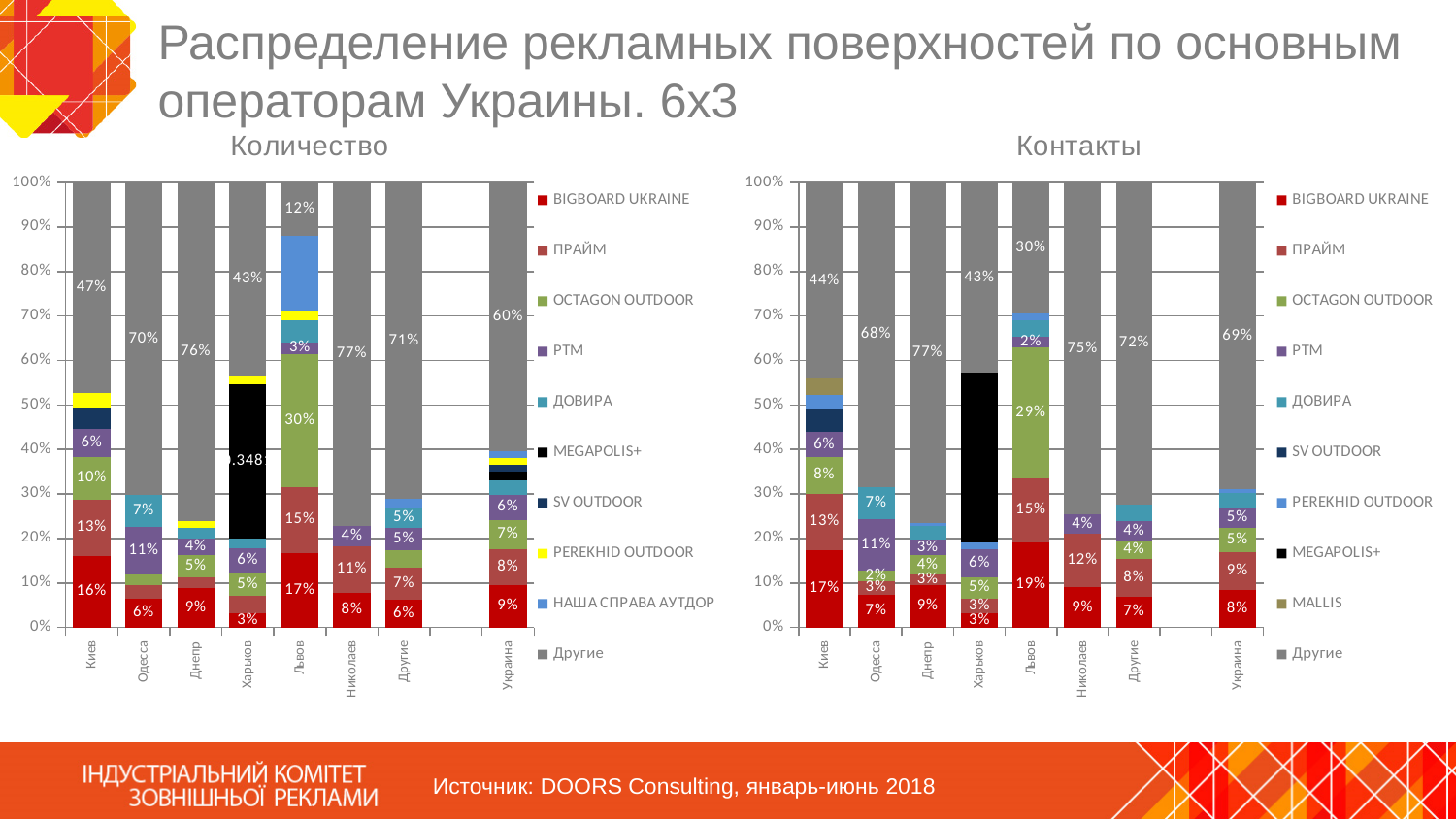
In the "Количество" chart, what is the difference between the Другие share in Днепр and in Киев? 29% In the "Количество" chart, is the Другие share for Украина greater or less than 50%? greater In the "Контакты" chart, which is larger: the BIGBOARD UKRAINE share in Львов or in Киев? Львов In the "Контакты" chart, which city has the largest share of Другие? Днепр What type of chart is the "Количество" chart on the left? Stacked bar chart How many categories are shown on the x axis of the "Количество" chart? 8 In the "Количество" chart, what is the share of OCTAGON OUTDOOR in Львов? 30% In the "Контакты" chart, what is the share of ПРАЙМ in Николаев? 12% How many series does the legend of the "Контакты" chart list? 10 In the "Контакты" chart, what is the share of Другие in Львов? 30% In the "Количество" chart, what is the share of BIGBOARD UKRAINE in Киев? 16% In the "Количество" chart, what is the share of Другие in Николаев? 77%